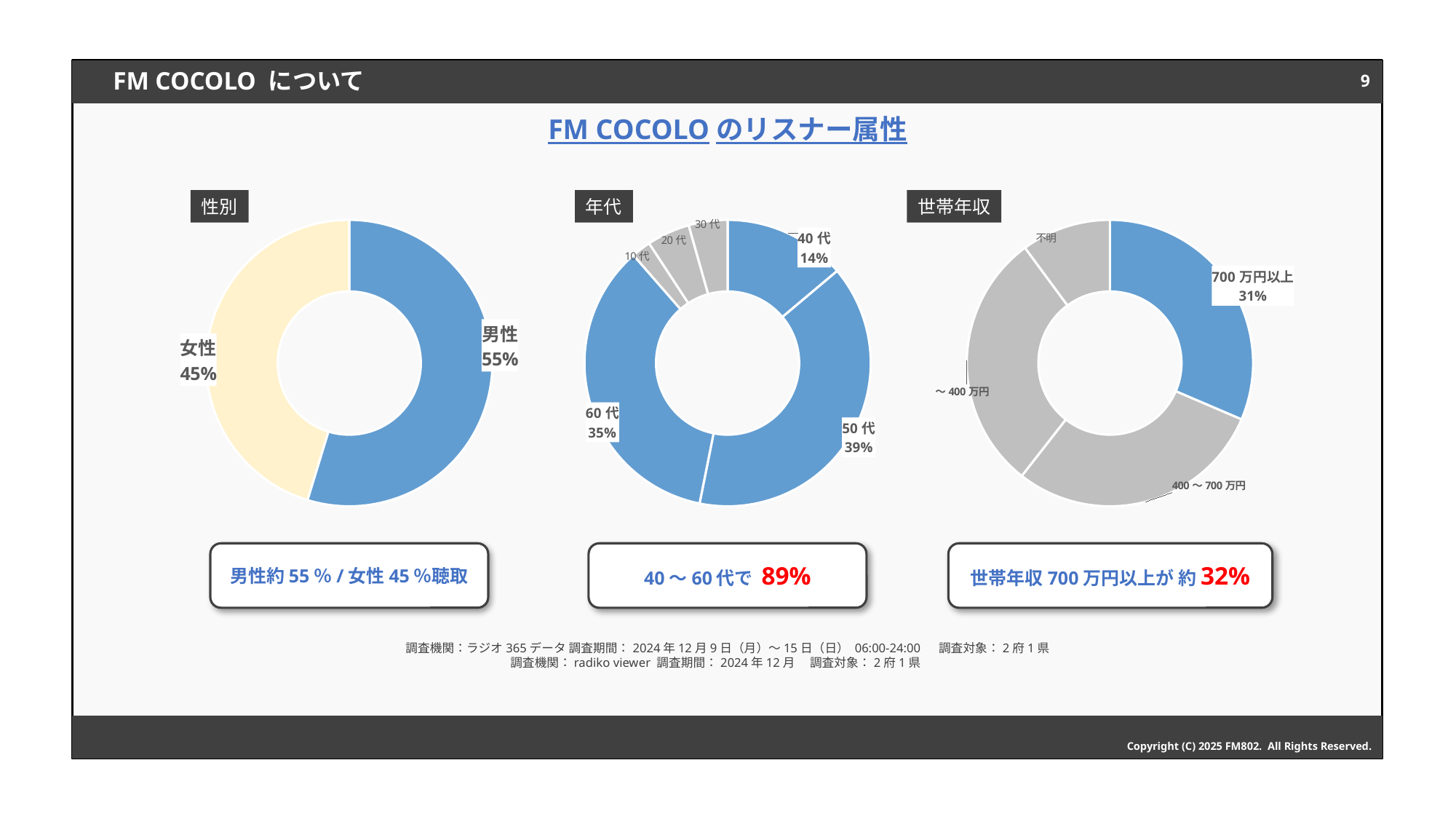
In the 性別 chart, what share of listeners is 女性? 45% In the 年代 chart, what share of listeners is 50 代? 39% In the 年代 chart, which age group has the largest share? 50 代 In the 世帯年収 chart, how many segments are shown? 4 In the 世帯年収 chart, what share of listeners has a household income of 700 万円以上? 31% In the 性別 chart, what is the difference between the 男性 and 女性 shares? 10% In the 性別 chart, what share of listeners is 男性? 55% In the 年代 chart, what share of listeners is 40 代? 14% In the 性別 chart, which segment is larger, 男性 or 女性? 男性 In the 年代 chart, how many age-group segments are shown? 6 What kind of chart is used for the 性別 data? Donut (pie) chart In the 年代 chart, what share of listeners is 60 代? 35%